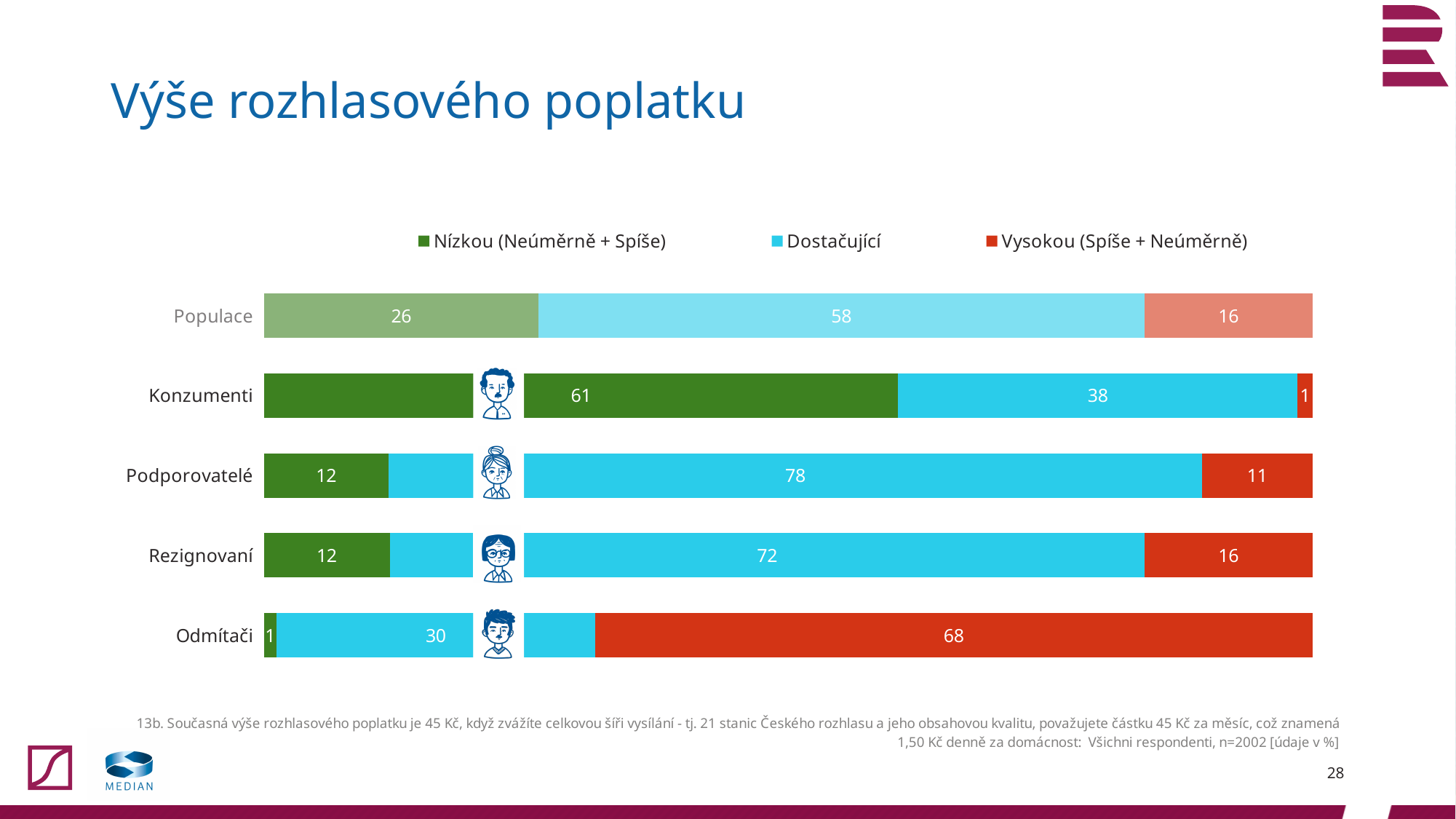
How many categories (rows) are plotted in the chart? 5 What is the difference between the Dostačující values for Podporovatelé and Rezignovaní? 6 Which is larger: the Vysokou (Spíše + Neúměrně) value for Rezignovaní or for Podporovatelé? Rezignovaní What is the value of Nízkou (Neúměrně + Spíše) for Konzumenti? 61 Which category has the highest value for Vysokou (Spíše + Neúměrně)? Odmítači How many series does the legend list? 3 What is the value of Dostačující for Podporovatelé? 78 What is the value of Vysokou (Spíše + Neúměrně) for Odmítači? 68 What kind of chart is shown on the slide? stacked bar chart What is the value of Dostačující for Populace? 58 Which category has the lowest value for Dostačující? Odmítači What is the title of the chart slide? Výše rozhlasového poplatku